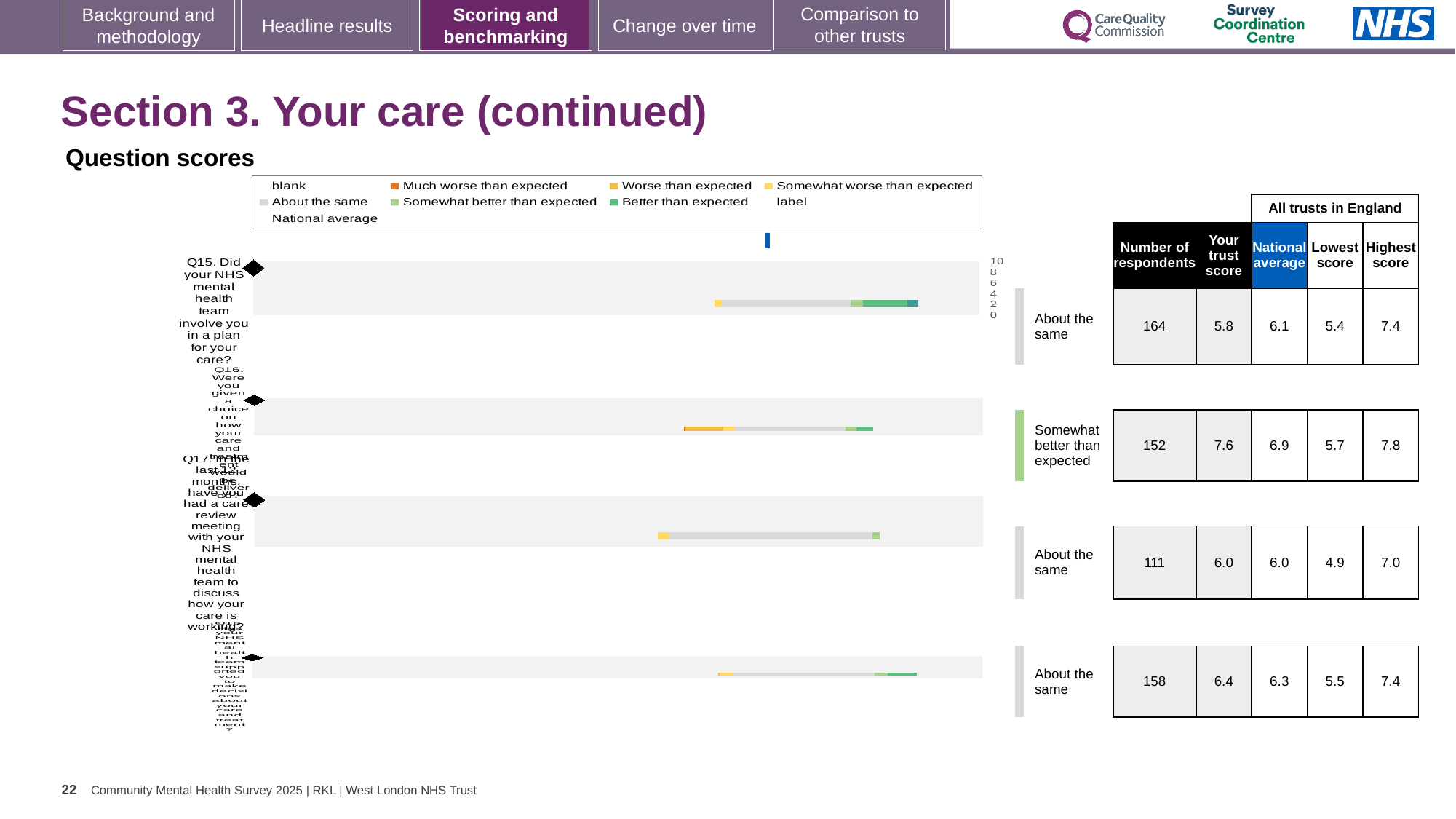
How many entries does the legend of the question scores chart list? 9 What is the highest score among all trusts in England for Q16? 7.8 Which question has the highest 'Your trust score' in the table? Q16 What is the national average score for Q16 (Were you given a choice on how your care and treatment would be delivered)? 6.9 What benchmark category is shown for Q16 in the question scores chart? Somewhat better than expected What is the difference between the trust score and the national average for Q16? 0.7 For Q15, which is larger: the trust score or the national average? National average What is the 'Your trust score' value for Q15 (Did your NHS mental health team involve you in a plan for your care?)? 5.8 Which question has the lowest number of respondents? Q17 What kind of chart is used to show the question scores on this slide? bar chart How many questions (bars) are plotted in the question scores chart? 4 How many respondents answered Q17 (In the last 12 months, have you had a care review meeting)? 111